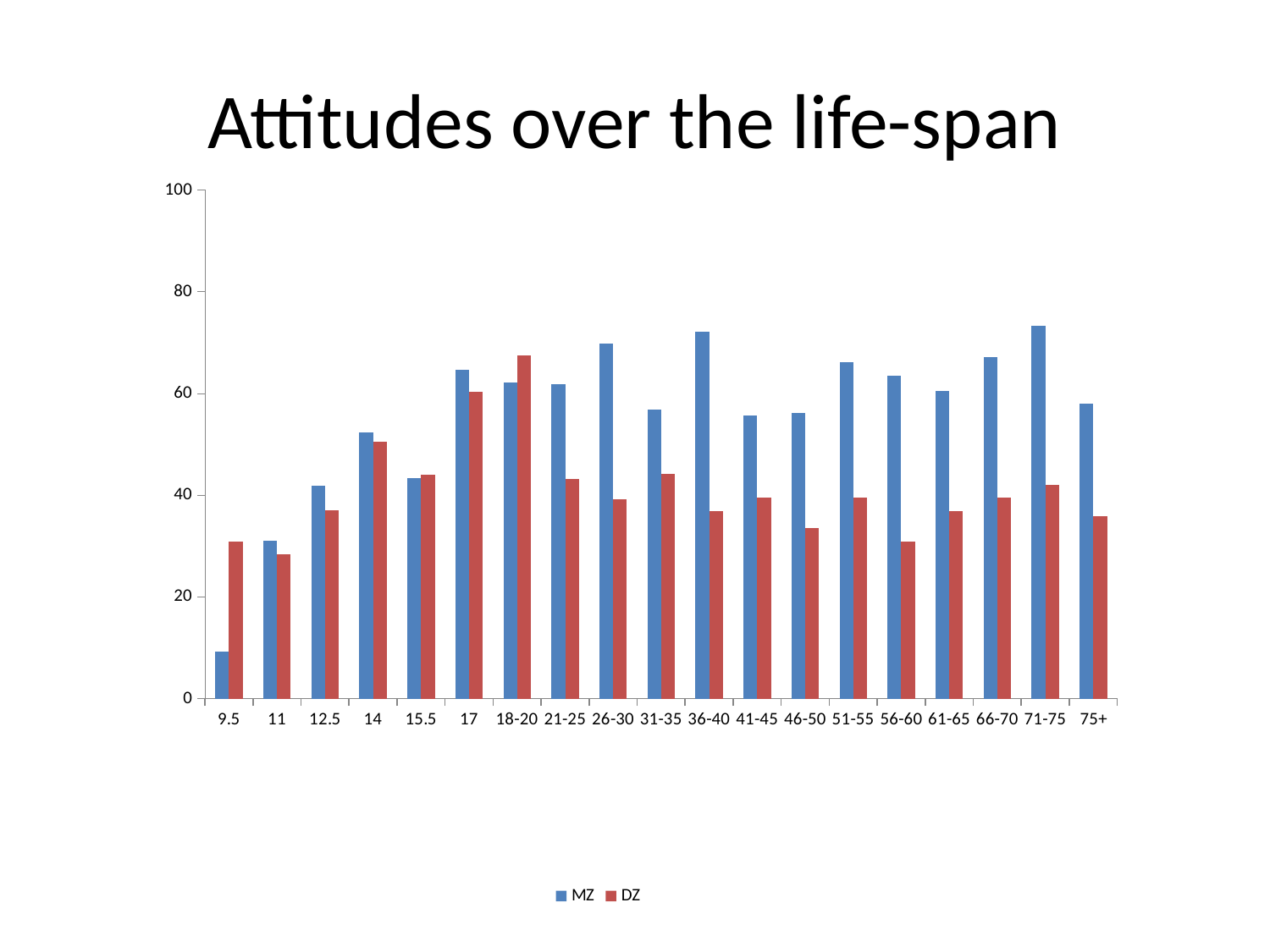
How many age categories are shown on the x axis? 19 What kind of chart is shown on the slide? bar chart Is the MZ value for 36-40 greater or less than 60? greater Is the DZ value for 46-50 greater or less than 40? less Which age category has the lowest MZ value? 9.5 Is the MZ value for 9.5 greater or less than 20? less What is the title of the chart? Attitudes over the life-span How many series does the legend list? 2 For the 9.5 category, which series has the larger value, MZ or DZ? DZ For the 36-40 category, which series has the larger value, MZ or DZ? MZ Which age category has the highest DZ value? 18-20